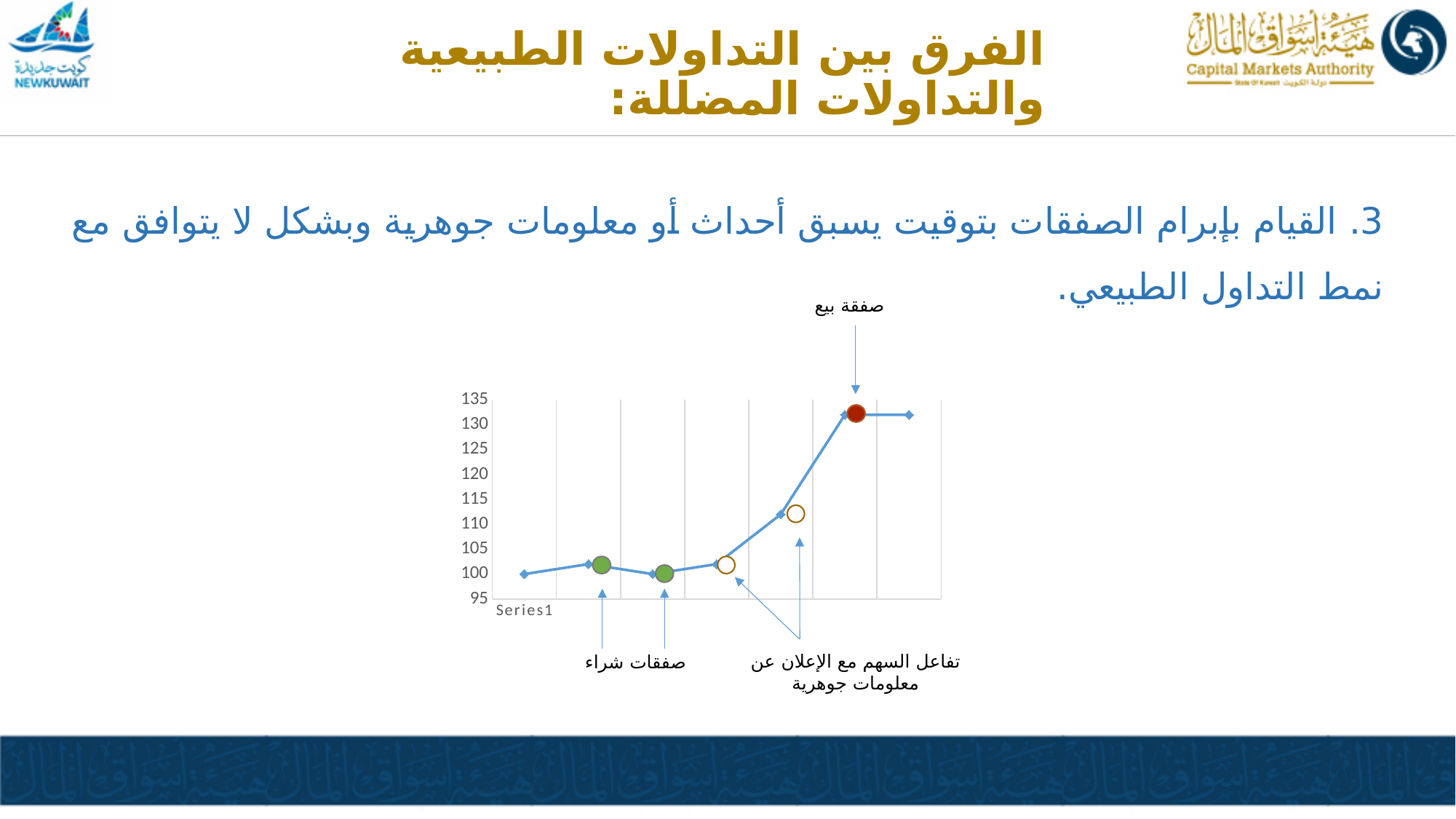
Are the values at the points marked "صفقات شراء" greater or less than 110? less What label appears on the horizontal axis of the chart? Series1 What kind of chart is shown on the slide? line chart Is the value at the second hollow circle (the one just before the steep rise) greater or less than 120? less What is the highest value shown on the vertical axis of the chart? 135 Is the value at the second hollow circle (the one just before the steep rise) greater or less than 105? greater How many data points are plotted on the line in the chart? 7 Which is larger: the value at the point labelled "صفقة بيع" or the value at the first point on the line? the point labelled "صفقة بيع" Do the values on the chart generally rise or fall from left to right? rise Which is larger: the value at the last point on the line or the value at the point marked "صفقات شراء" on the far left? the last point on the line